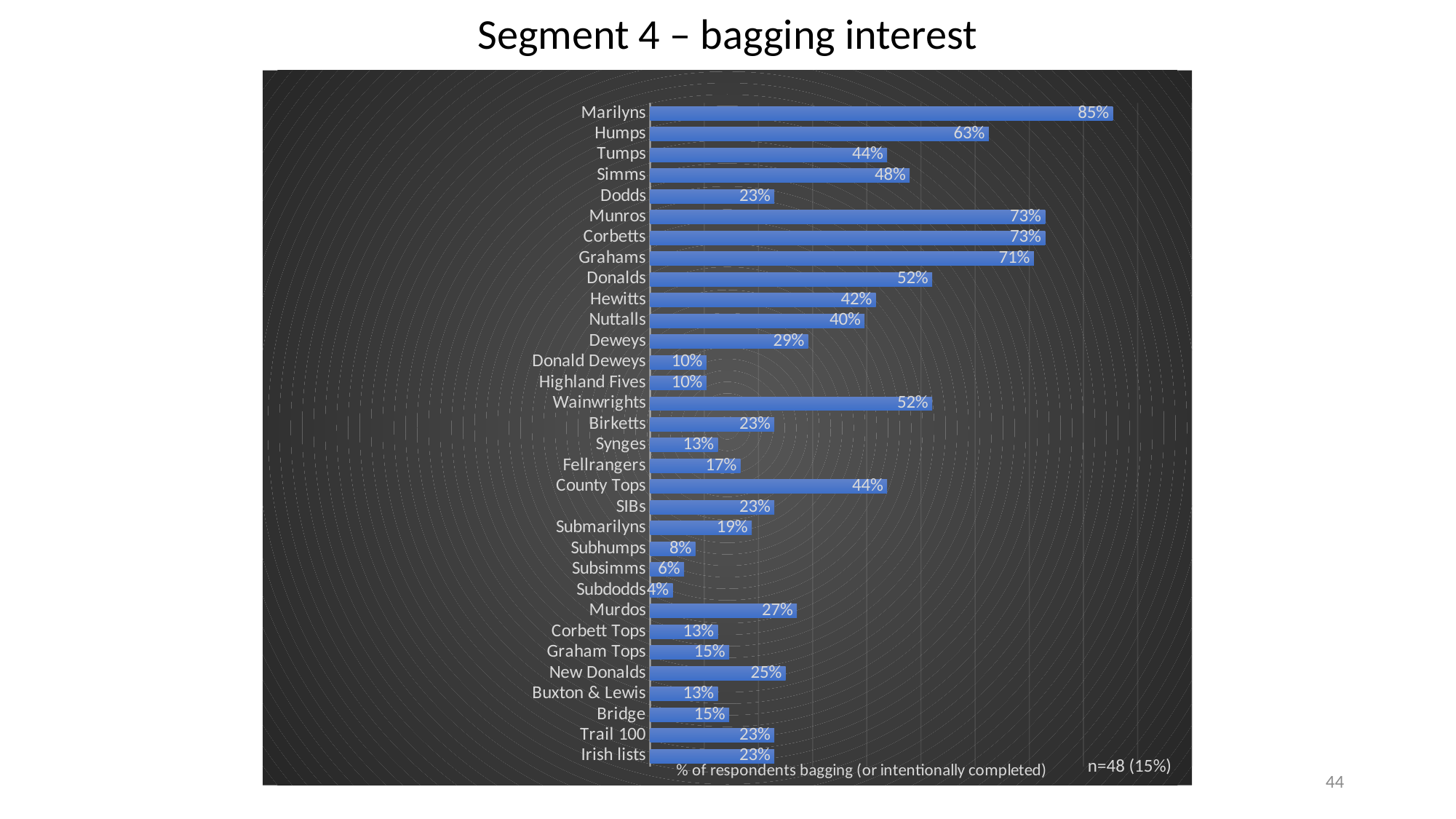
Which category has the highest value? Marilyns What is the title of the slide? Segment 4 – bagging interest What is the value for New Donalds? 25% What is the difference between the values for Munros and Donalds? 21% What is the difference between the values for Humps and Tumps? 19% Which is larger, the value for Simms or the value for Hewitts? Simms What is the value for Subhumps? 8% What is the value for Wainwrights? 52% How many categories are shown in the chart? 32 Which category has the lowest value? Subdodds What is the value for Marilyns? 85% What kind of chart is shown on the slide? Bar chart